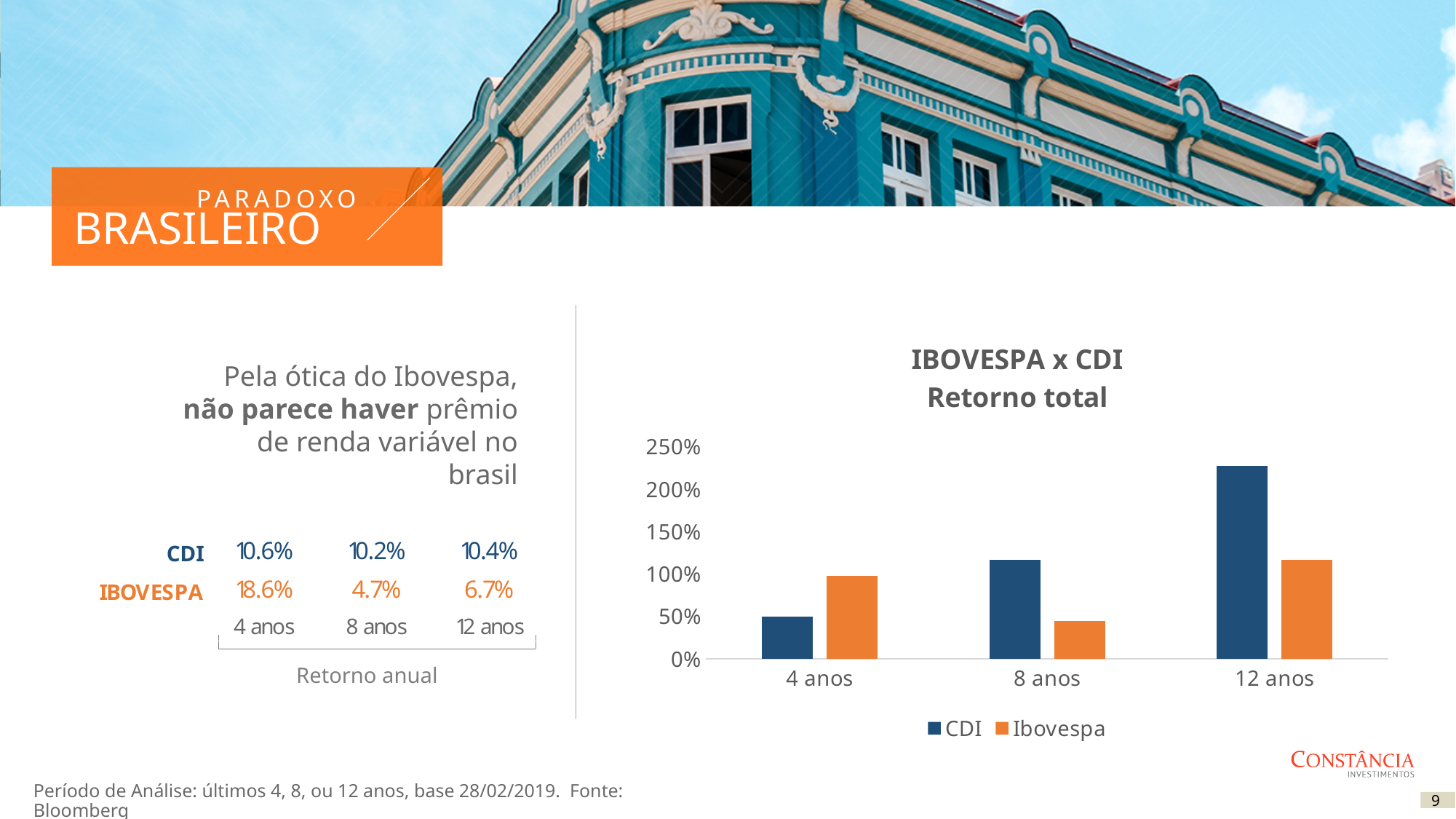
Which category has the lowest CDI bar in the chart? 4 anos How many series does the chart legend list? 2 Is the CDI value for 4 anos greater or less than 100%? less How many categories are shown on the x axis of the chart? 3 Is the Ibovespa value for 8 anos greater or less than 100%? less Which category has the highest CDI bar in the chart? 12 anos Do the CDI bars rise or fall as you move from 4 anos to 12 anos along the x axis? rise What kind of chart is shown on the slide? bar chart What is the title of the chart? IBOVESPA x CDI Retorno total In the 8 anos category, which series has the larger bar, CDI or Ibovespa? CDI Is the CDI value for 12 anos greater or less than 200%? greater In the 4 anos category, which series has the larger bar, CDI or Ibovespa? Ibovespa